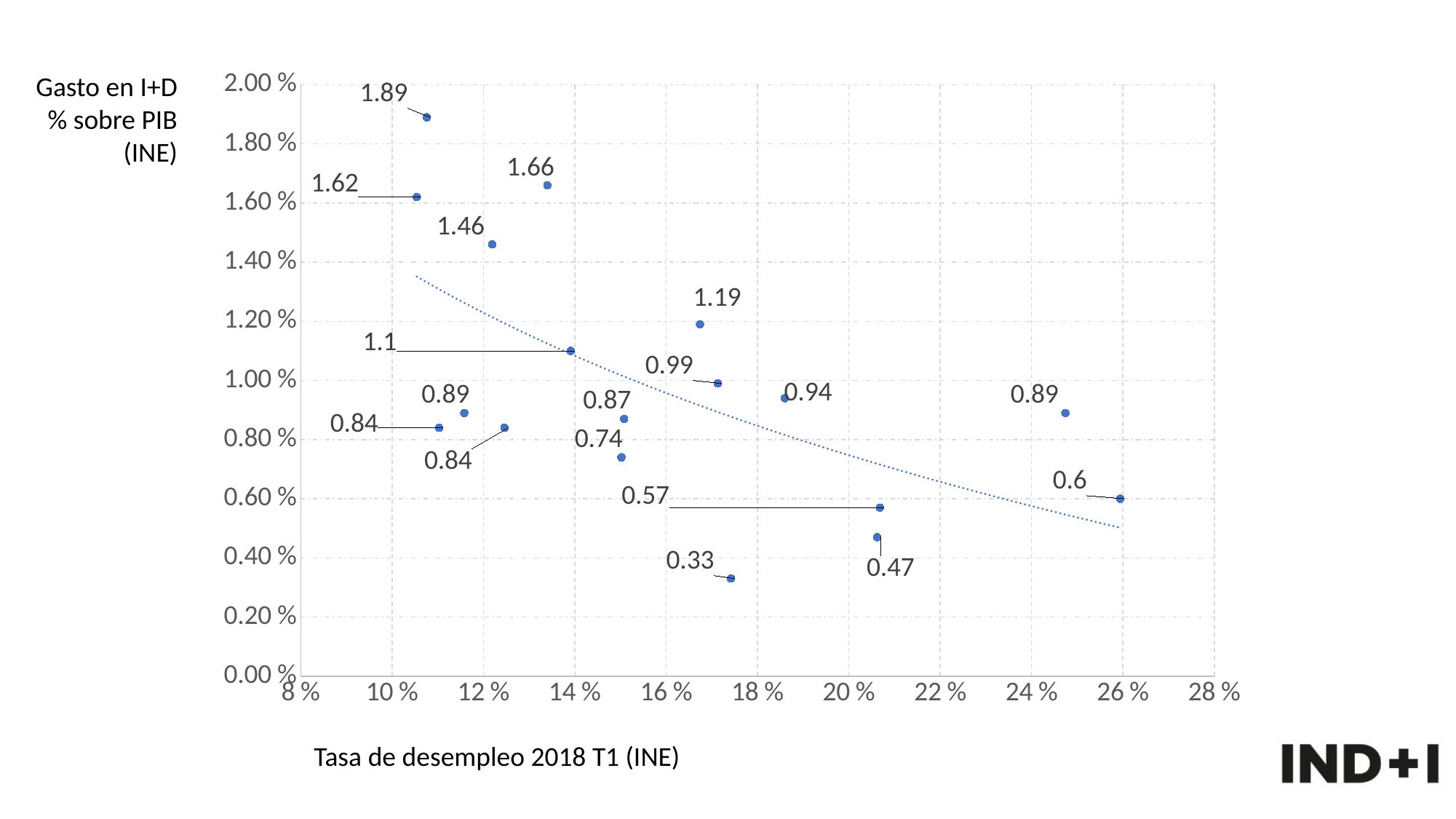
Which is larger, the point labeled 1.19 or the point labeled 0.99? 1.19 What kind of chart is shown on the slide? scatter chart Is the unemployment rate for the point labeled 0.6 greater or less than 24%? greater What is the difference between the highest labeled value (1.89) and the lowest labeled value (0.33)? 1.56 What is the difference between the points labeled 1.66 and 1.46? 0.2 Is the unemployment rate for the point labeled 1.89 greater or less than 12%? less How many data points are plotted on the chart? 18 How many points have an R&D spending value above 1.40%? 4 As the unemployment rate increases along the x axis, does R&D spending as % of GDP generally rise or fall? fall What is the title of the x axis? Tasa de desempleo 2018 T1 (INE) What is the highest R&D spending value labeled on the chart? 1.89 What is the lowest R&D spending value labeled on the chart? 0.33